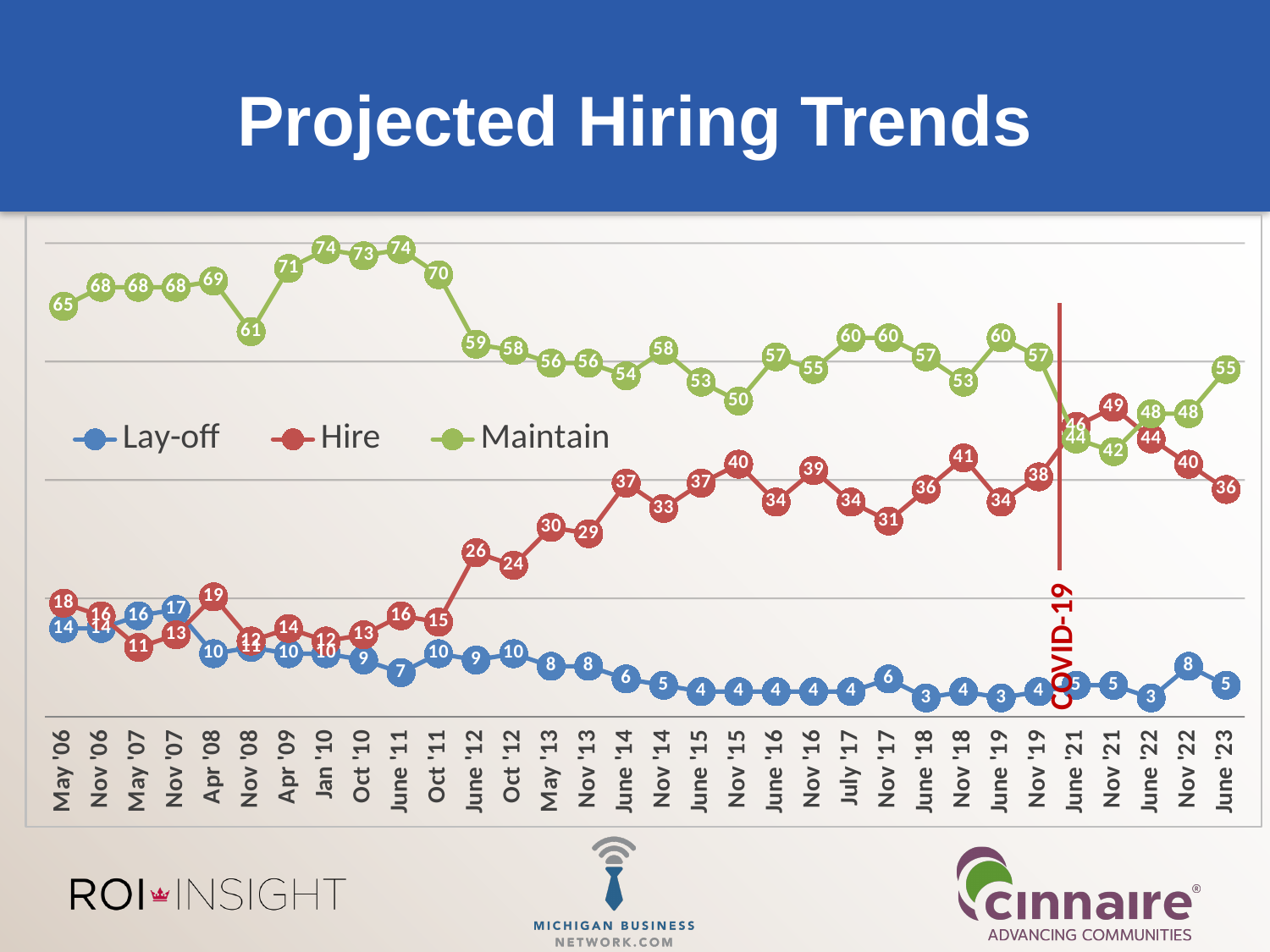
At which date does the Maintain series reach its lowest value? Nov '21 How many series does the legend list? 3 What event does the red vertical line on the chart mark? COVID-19 Does the Hire series generally rise or fall from Oct '11 to Nov '15? rise What is the Maintain value for Jan '10? 74 What is the Lay-off value for June '11? 7 What kind of chart is shown on the slide? line chart What is the Hire value for Nov '18? 41 How many dates are shown on the x axis? 32 For Nov '19, which is larger: the Maintain value or the Hire value? Maintain At which date does the Hire series reach its highest value? Nov '21 What is the difference between the Hire value and the Lay-off value for June '23? 31